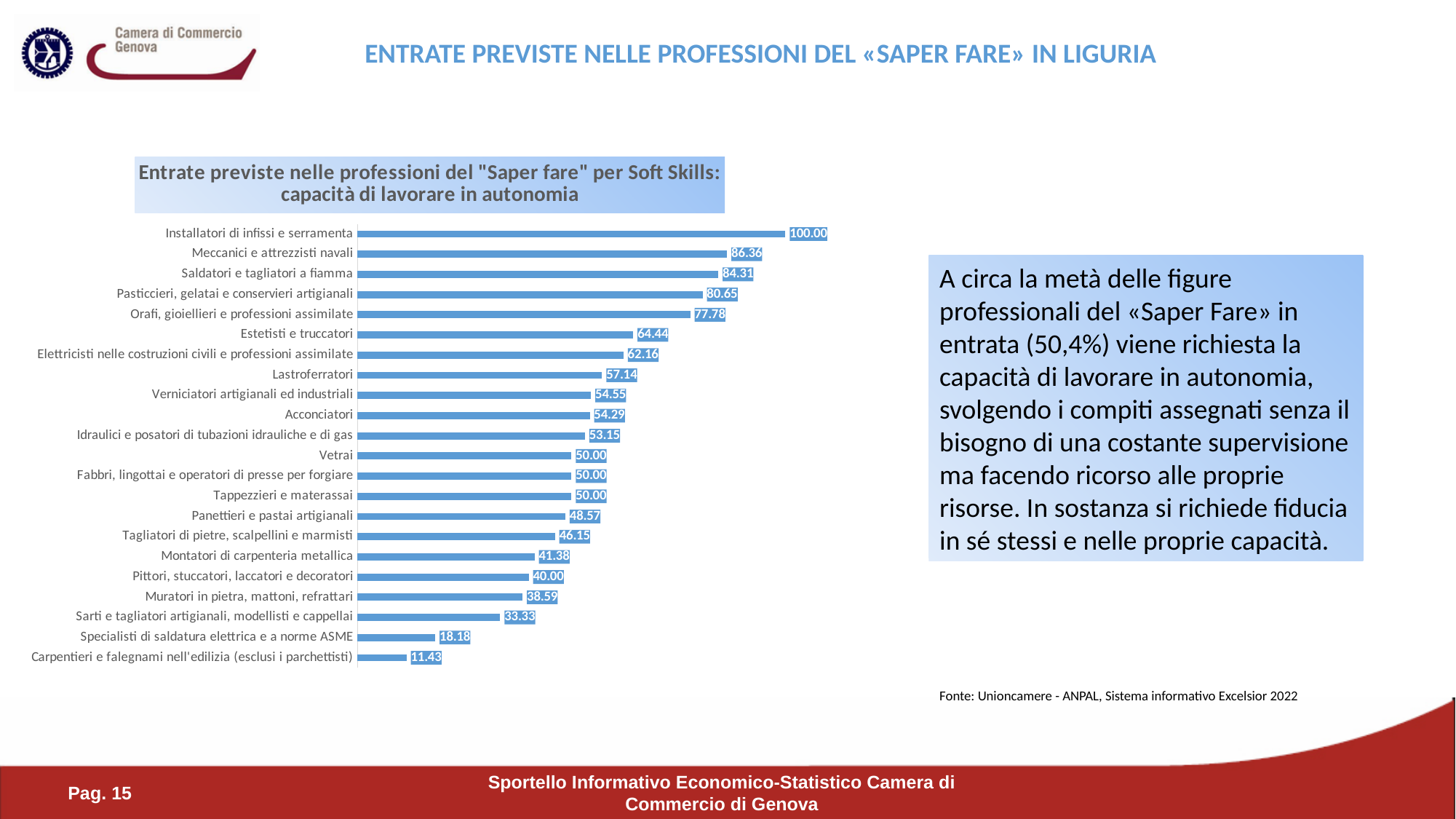
What is the value for Lastroferratori? 57.14 What is the difference between the values for Meccanici e attrezzisti navali and Saldatori e tagliatori a fiamma? 2.05 How many categories are shown in the chart? 22 Which category has the highest value? Installatori di infissi e serramenta What is the value for Estetisti e truccatori? 64.44 Which category has the lowest value? Carpentieri e falegnami nell'edilizia (esclusi i parchettisti) Which is larger, the value for Orafi, gioiellieri e professioni assimilate or the value for Pasticcieri, gelatai e conservieri artigianali? Pasticcieri, gelatai e conservieri artigianali What is the value for Muratori in pietra, mattoni, refrattari? 38.59 What kind of chart is shown on the slide? Bar chart How many categories have a value of exactly 50.00? 3 What is the difference between the values for Sarti e tagliatori artigianali, modellisti e cappellai and Specialisti di saldatura elettrica e a norme ASME? 15.15 What is the title of the chart? Entrate previste nelle professioni del "Saper fare" per Soft Skills: capacità di lavorare in autonomia